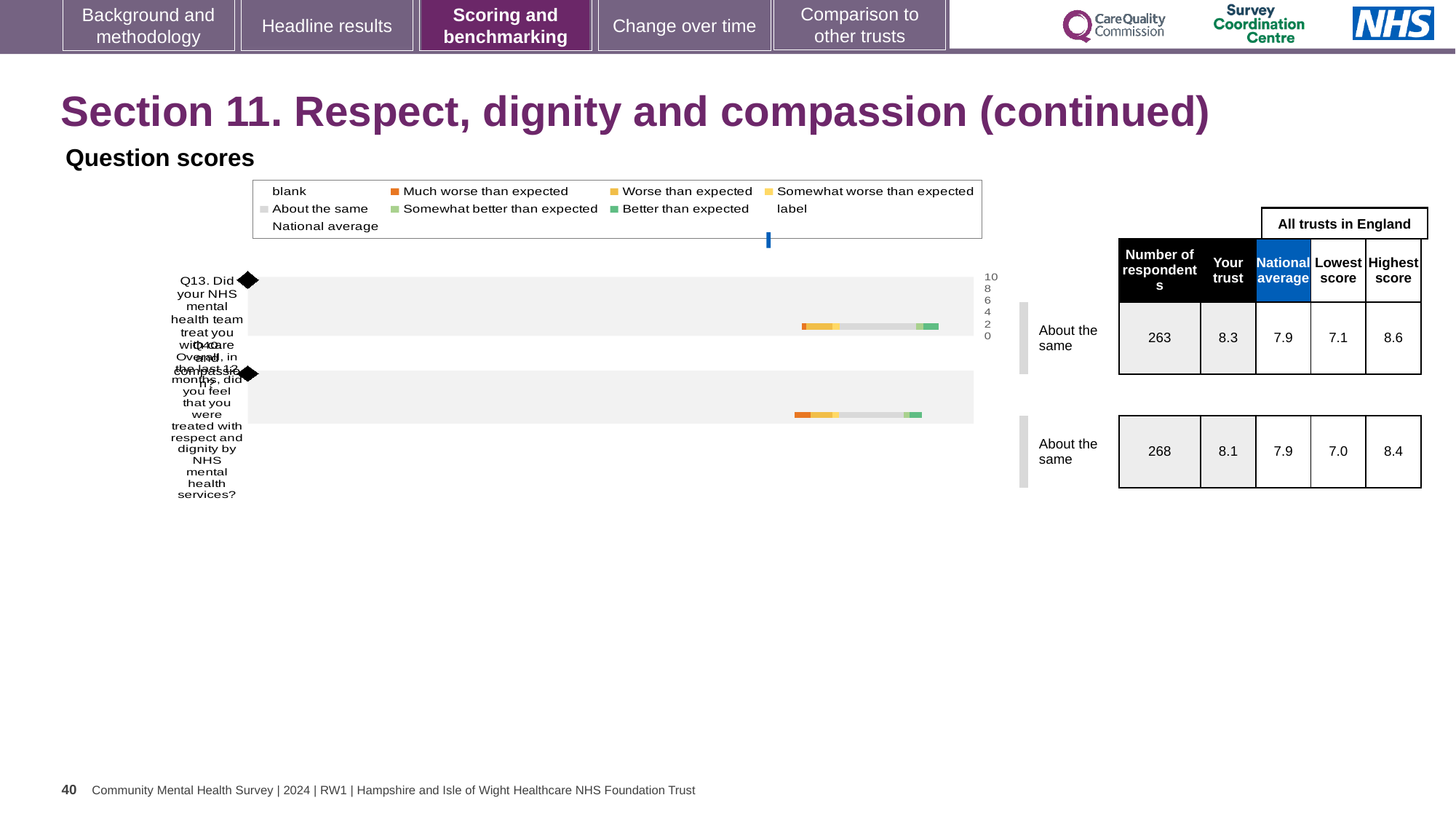
What benchmark category is shown for Q14 next to the chart? About the same What is the national average score shown for Q13? 7.9 What is the difference between the 'Your trust' score and the national average for Q13? 0.4 Which question has the higher 'Your trust' score, Q13 or Q14? Q13 What is the maximum value shown on the chart's score axis? 10 How many survey questions are plotted in the question scores chart? 2 What is the highest score among all trusts in England for Q13? 8.6 How many respondents are listed for Q14? 268 What is the 'Your trust' score for Q13 in the table next to the chart? 8.3 What is the lowest score among all trusts in England for Q14? 7.0 What is the 'Your trust' score for Q14 in the table next to the chart? 8.1 What kind of chart is used to show the question scores on this slide? bar chart